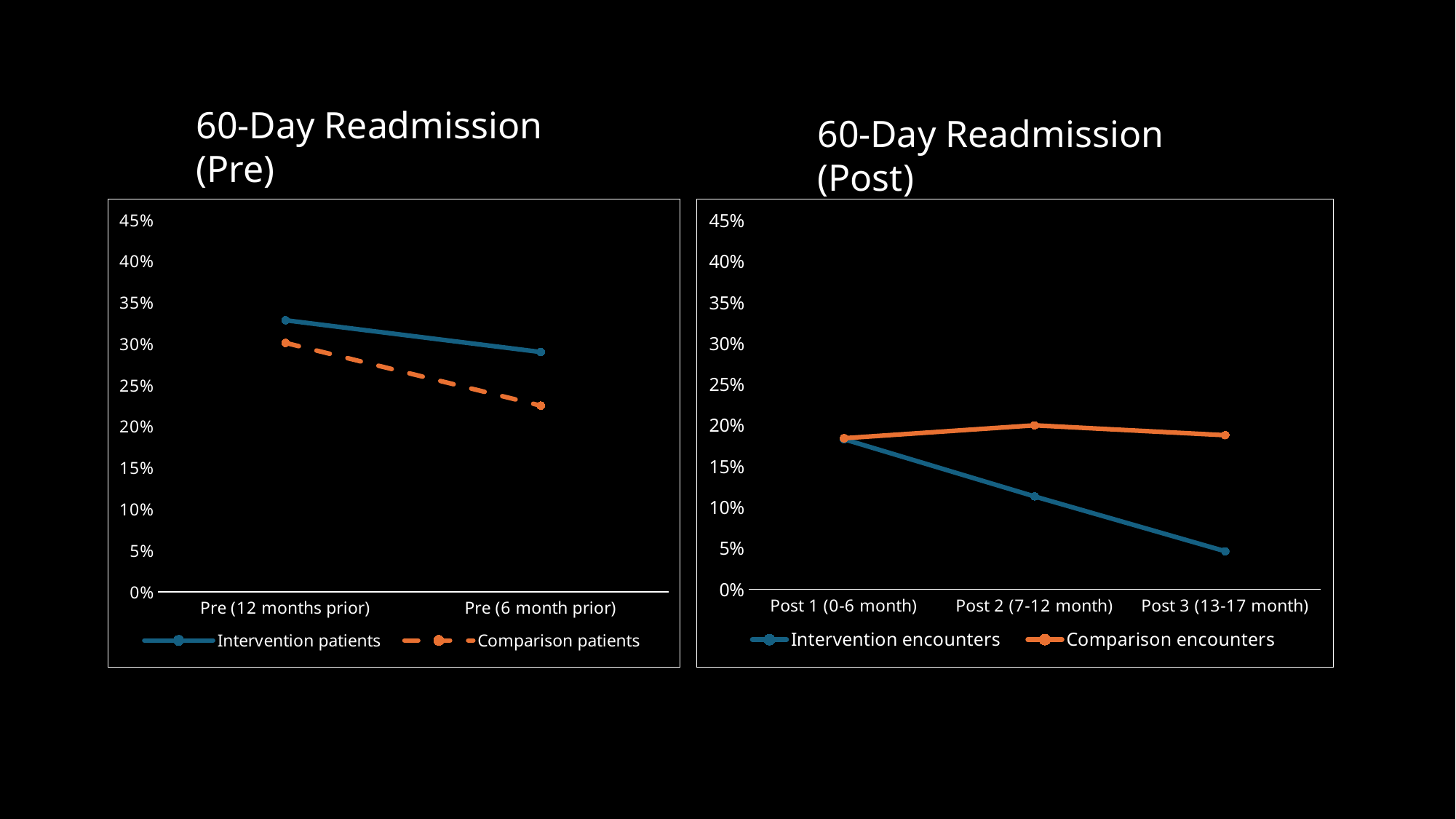
How many series does the legend of the 60-Day Readmission (Post) chart list? 2 In the 60-Day Readmission (Pre) chart, which series has the higher value at Pre (6 month prior)? Intervention patients In the 60-Day Readmission (Pre) chart, is the value for Intervention patients at Pre (12 months prior) greater or less than 30%? greater In the 60-Day Readmission (Post) chart, which series has the higher value at Post 3 (13-17 month)? Comparison encounters In the 60-Day Readmission (Pre) chart, which series is drawn with a dashed line? Comparison patients How many categories are on the x axis of the 60-Day Readmission (Pre) chart? 2 In the 60-Day Readmission (Post) chart, is the value for Comparison encounters at Post 2 (7-12 month) greater or less than 15%? greater In the 60-Day Readmission (Pre) chart, is the value for Comparison patients at Pre (6 month prior) greater or less than 25%? less How many categories are on the x axis of the 60-Day Readmission (Post) chart? 3 In the 60-Day Readmission (Post) chart, do the values for Intervention encounters rise or fall from Post 1 to Post 3? fall What kind of chart is the 60-Day Readmission (Pre) chart? line chart